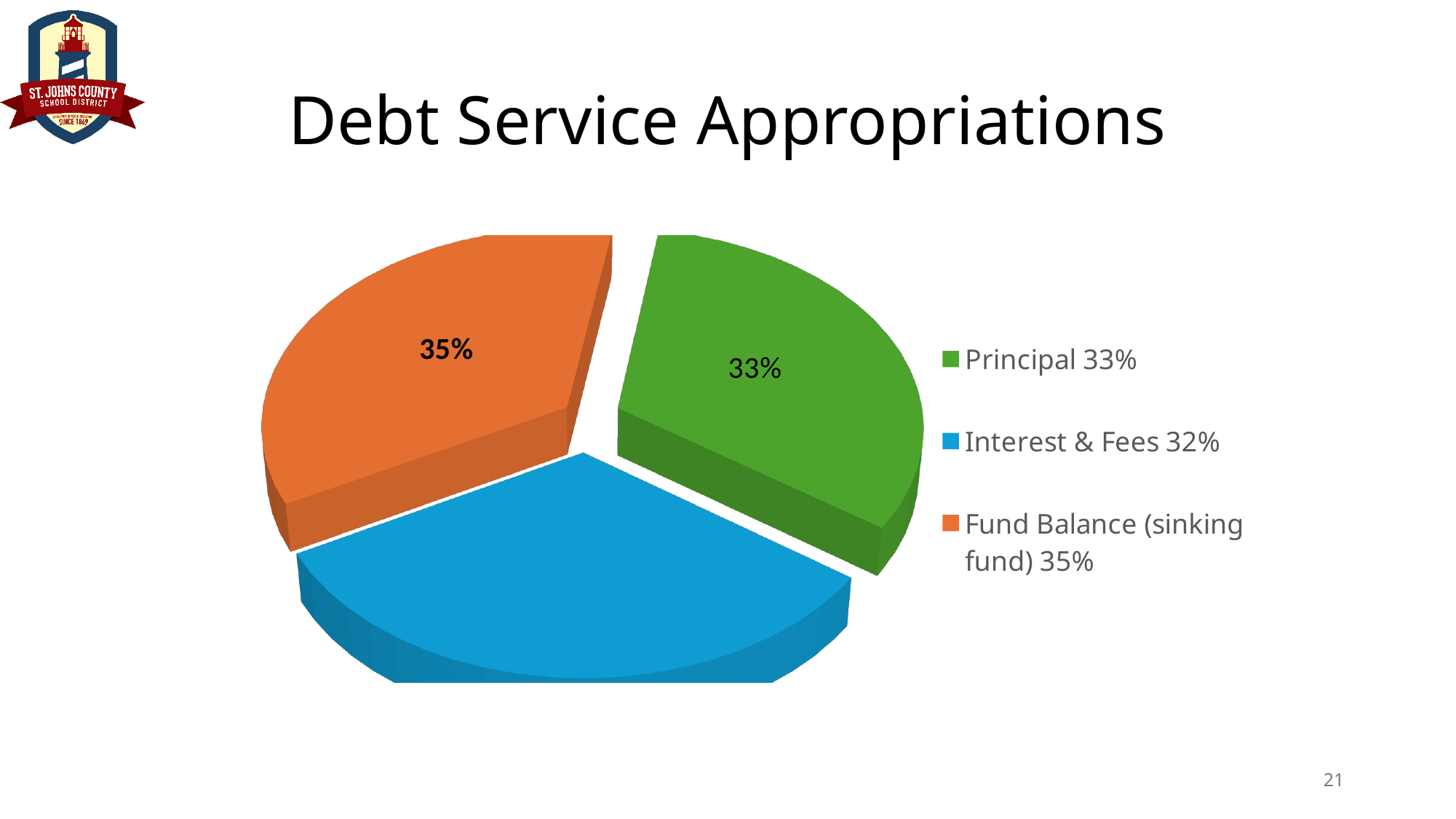
What share of the pie is Fund Balance (sinking fund)? 35% What share of the pie is Interest & Fees? 32% What kind of chart is shown on the slide? pie chart Which is larger, the share for Principal or the share for Interest & Fees? Principal Which category has the largest share of the pie? Fund Balance (sinking fund) How many slices does the pie chart have? 3 Which category has the smallest share of the pie? Interest & Fees What is the difference in percentage points between Fund Balance (sinking fund) and Principal? 2 What is the title of the chart on the slide? Debt Service Appropriations What colour is the Interest & Fees slice? blue What share of the pie is Principal? 33% What is the difference in percentage points between Fund Balance (sinking fund) and Interest & Fees? 3